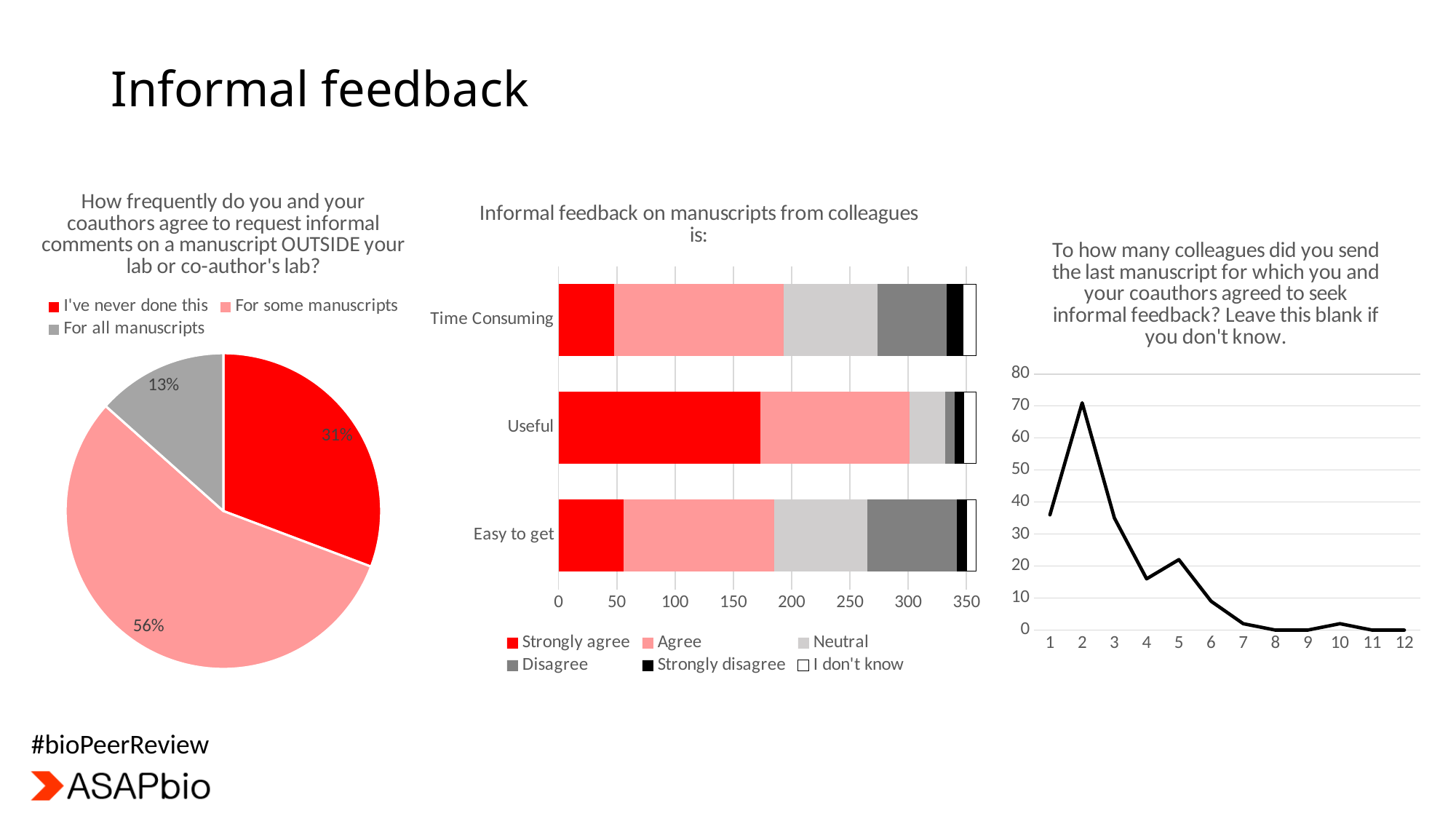
In the line chart on the right, at which x-axis value does the line reach its highest point? 2 In the pie chart on the left, how many slices are there? 3 In the middle chart titled "Informal feedback on manuscripts from colleagues is:", what kind of chart is it? stacked bar chart In the pie chart on the left, what percentage of respondents answered "For some manuscripts"? 56% In the line chart on the right, is the value at x = 2 greater or less than 60? greater In the middle chart titled "Informal feedback on manuscripts from colleagues is:", how many series does the legend list? 6 In the pie chart on the left, what percentage of respondents answered "I've never done this"? 31% In the middle chart titled "Informal feedback on manuscripts from colleagues is:", is the "Strongly agree" value for "Useful" greater or less than 150? greater In the middle chart titled "Informal feedback on manuscripts from colleagues is:", which category has the largest "Strongly agree" segment? Useful In the line chart on the right, how many points are plotted along the x axis? 12 In the pie chart on the left, which response has the smallest share? For all manuscripts In the pie chart on the left, what is the difference in percentage points between "For some manuscripts" and "I've never done this"? 25